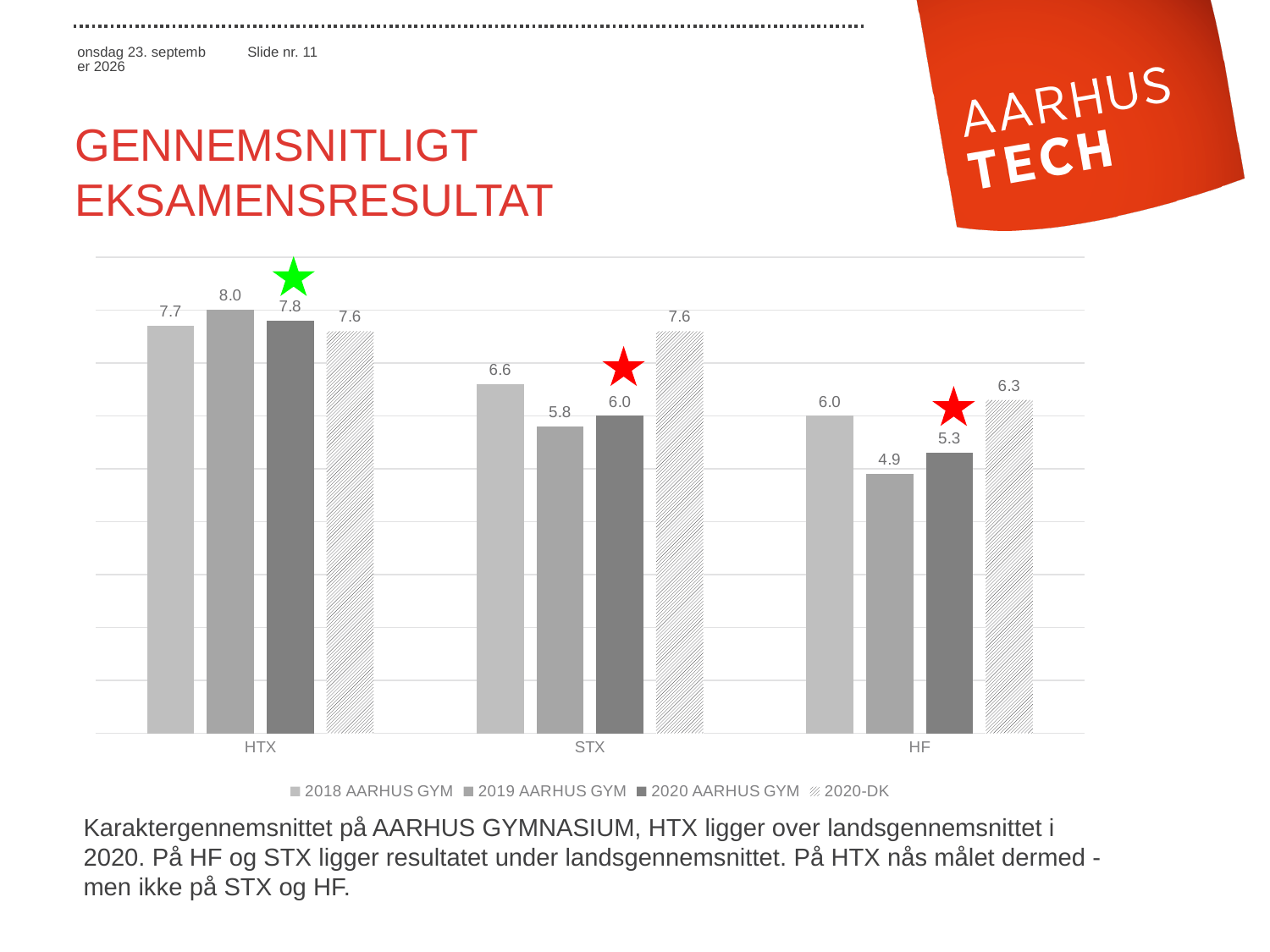
Which category has the highest 2020 AARHUS GYM value? HTX Which category has the lowest 2019 AARHUS GYM value? HF How many series does the legend list? 4 What is the 2019 AARHUS GYM value for HF? 4.9 Which is larger for HF: the 2020 AARHUS GYM value or the 2020-DK value? 2020-DK How many categories are shown on the x axis? 3 What is the 2020 AARHUS GYM value for HTX? 7.8 What kind of chart is shown on the slide? Bar chart What is the 2020-DK value for STX? 7.6 What is the difference between the 2020-DK value and the 2020 AARHUS GYM value for STX? 1.6 What is the 2018 AARHUS GYM value for STX? 6.6 Which series is drawn with a hatched pattern in the legend? 2020-DK